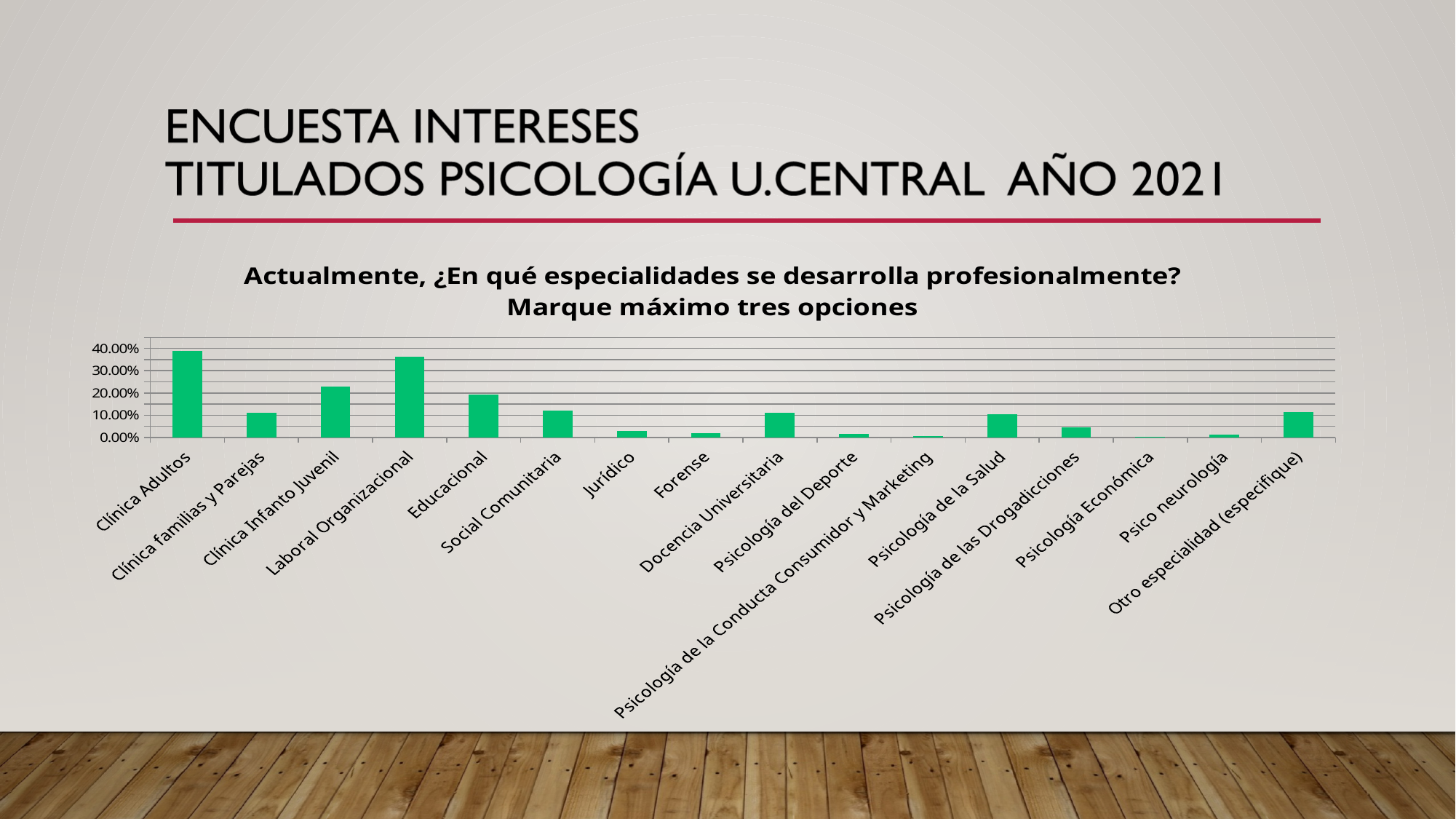
Which is larger, the value for Clínica Infanto Juvenil or the value for Educacional? Clínica Infanto Juvenil Which is larger, the value for Clínica Adultos or the value for Laboral Organizacional? Clínica Adultos Is the value for Clínica Adultos greater or less than 30.00%? greater How many categories (specialties) are shown on the x axis of the chart? 16 Is the value for Jurídico greater or less than 10.00%? less Which specialty has the highest value in the chart? Clínica Adultos Is the value for Laboral Organizacional greater or less than 30.00%? greater What is the title of the chart? Actualmente, ¿En qué especialidades se desarrolla profesionalmente? Marque máximo tres opciones What kind of chart is shown on the slide? Bar chart